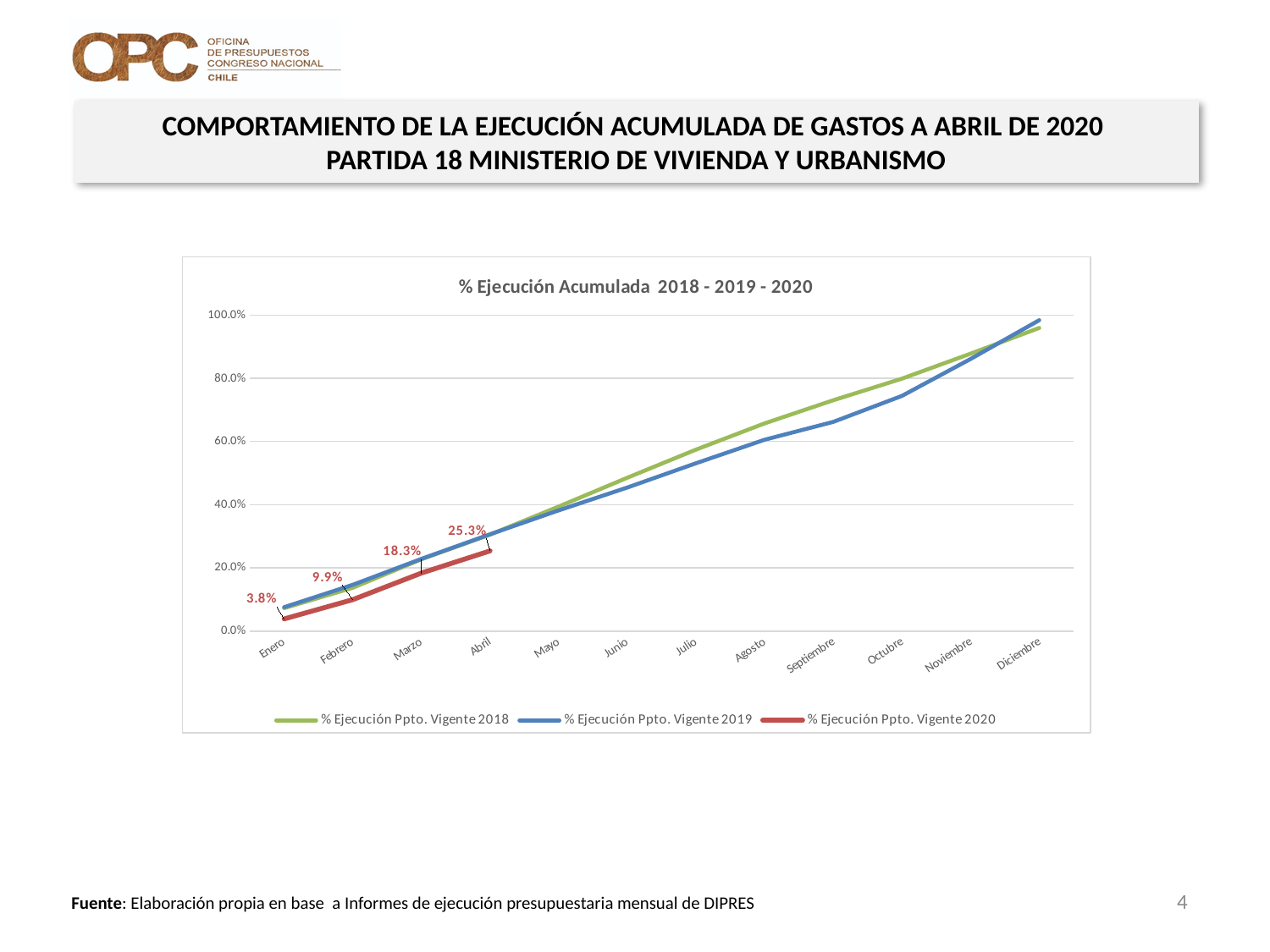
What is the value for Enero in the % Ejecución Ppto. Vigente 2020 series? 3.8% What kind of chart is shown on the slide? Line chart What is the value for Febrero in the % Ejecución Ppto. Vigente 2020 series? 9.9% Is the value for Diciembre in the % Ejecución Ppto. Vigente 2019 series greater or less than 80.0%? greater What is the value for Marzo in the % Ejecución Ppto. Vigente 2020 series? 18.3% Do the values of the % Ejecución Ppto. Vigente 2019 series rise or fall from Enero to Diciembre? Rise What is the title of the chart? % Ejecución Acumulada 2018 - 2019 - 2020 What is the difference between the Abril and Marzo values in the % Ejecución Ppto. Vigente 2020 series? 7.0% How many months are shown on the x axis? 12 What is the value for Abril in the % Ejecución Ppto. Vigente 2020 series? 25.3% How many series does the legend list? 3 Which month has the highest value in the % Ejecución Ppto. Vigente 2020 series? Abril